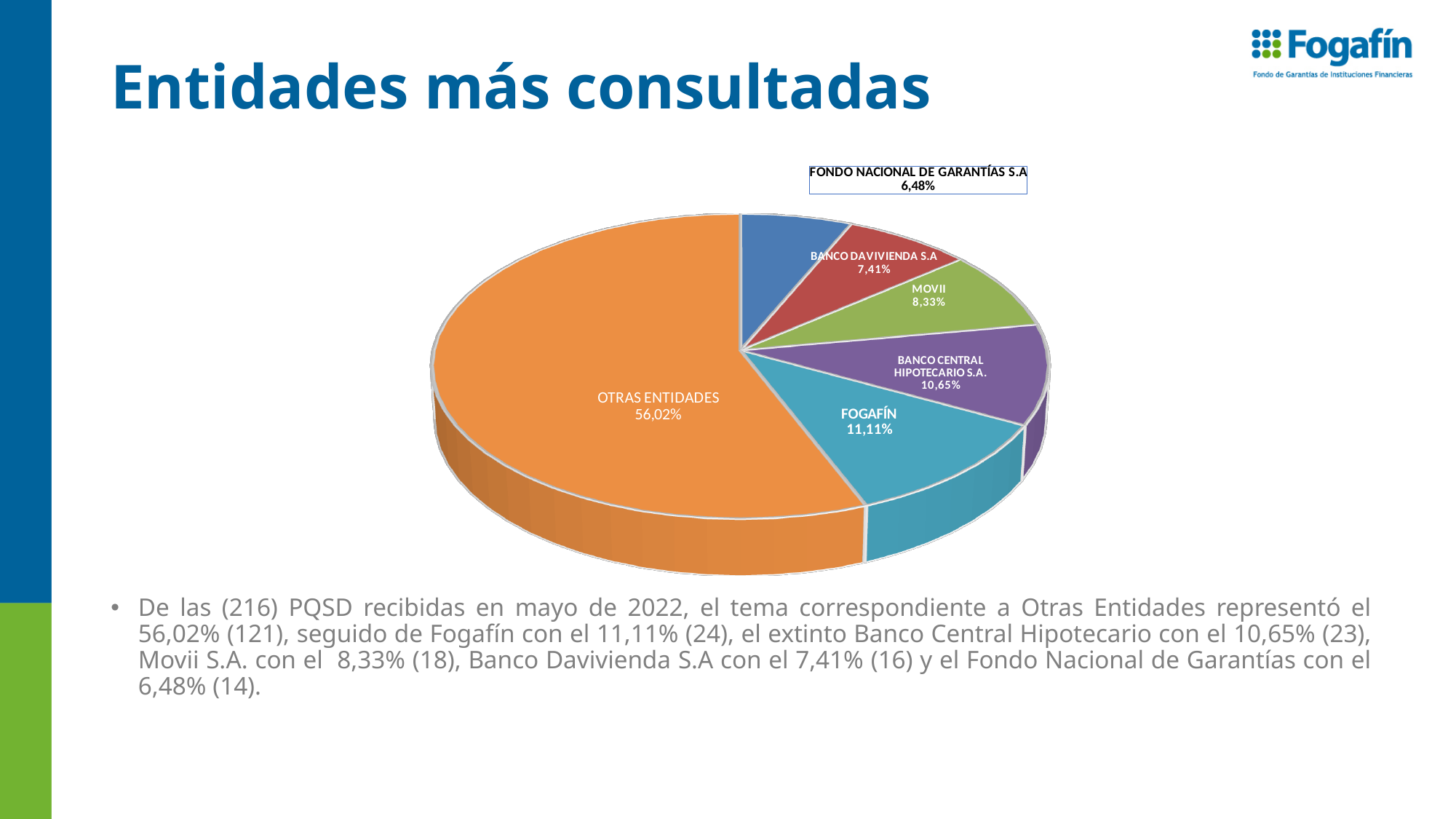
Which category has the largest slice of the pie? OTRAS ENTIDADES What is the value shown for FONDO NACIONAL DE GARANTÍAS S.A? 6,48% Which is larger, the slice for MOVII or the slice for BANCO DAVIVIENDA S.A? MOVII How many slices does the pie chart have? 6 What is the value shown for FOGAFÍN? 11,11% What is the value shown for MOVII? 8,33% What is the value shown for BANCO DAVIVIENDA S.A? 7,41% What is the difference in percentage points between FOGAFÍN and BANCO CENTRAL HIPOTECARIO S.A.? 0,46 What is the value shown for BANCO CENTRAL HIPOTECARIO S.A.? 10,65% What share of the pie does OTRAS ENTIDADES represent? 56,02% What kind of chart is shown on the slide? Pie chart Which category has the smallest slice of the pie? FONDO NACIONAL DE GARANTÍAS S.A